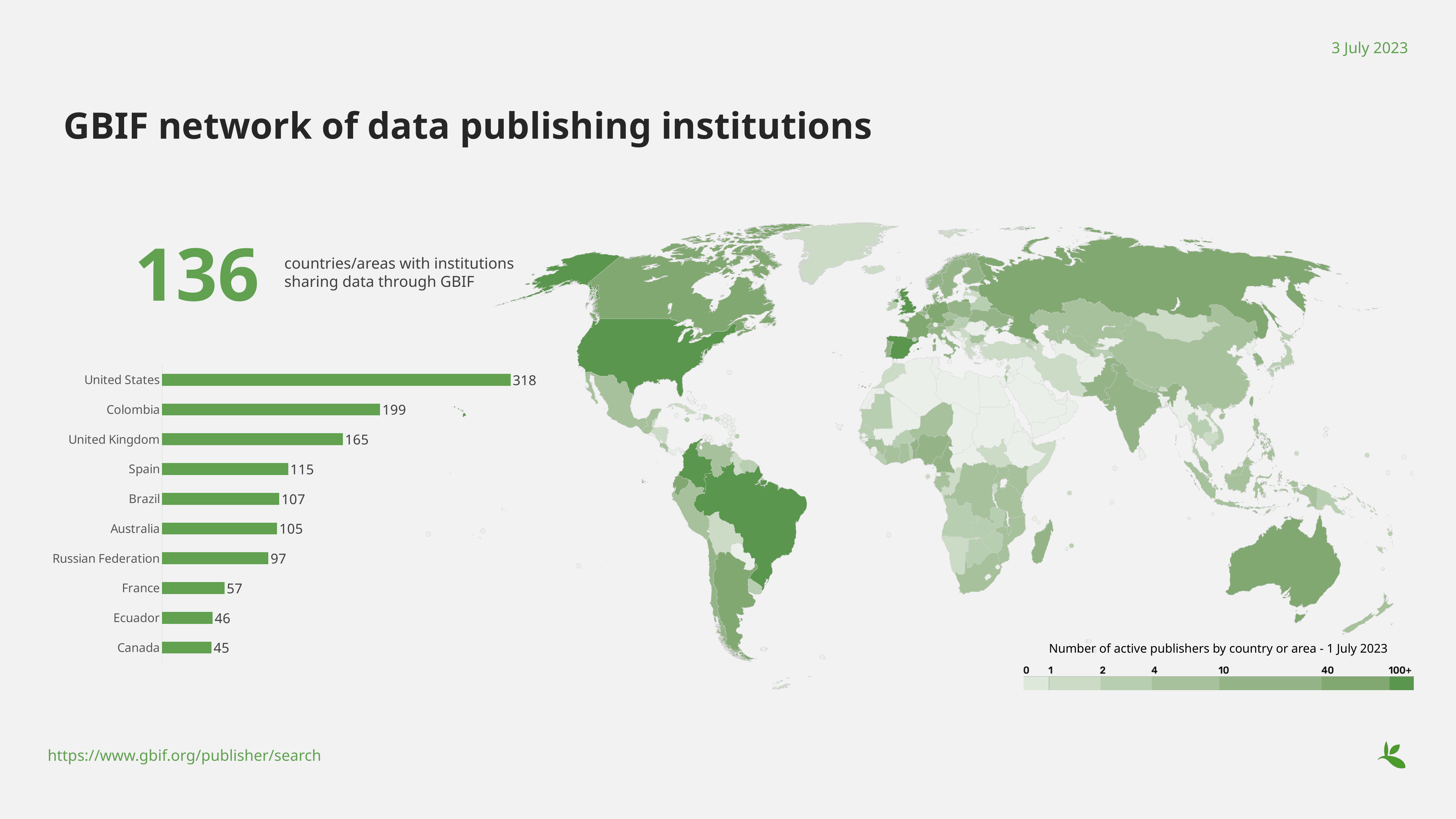
What is the title of the map legend on the right of the slide? Number of active publishers by country or area - 1 July 2023 In the bar chart, which country has the highest value? United States In the bar chart, what is the difference between the values for Spain and Brazil? 8 In the bar chart, which is larger, the value for France or the value for Ecuador? France In the bar chart, what is the value for Colombia? 199 In the bar chart, what is the value for the Russian Federation? 97 What kind of chart is shown on the left of the slide? Bar chart In the bar chart, which country has the lowest value? Canada In the bar chart, which is larger, the value for the United Kingdom or the value for Spain? United Kingdom How many countries are shown in the bar chart? 10 In the bar chart, what is the value for the United States? 318 In the bar chart, what is the difference between the values for the United States and Colombia? 119